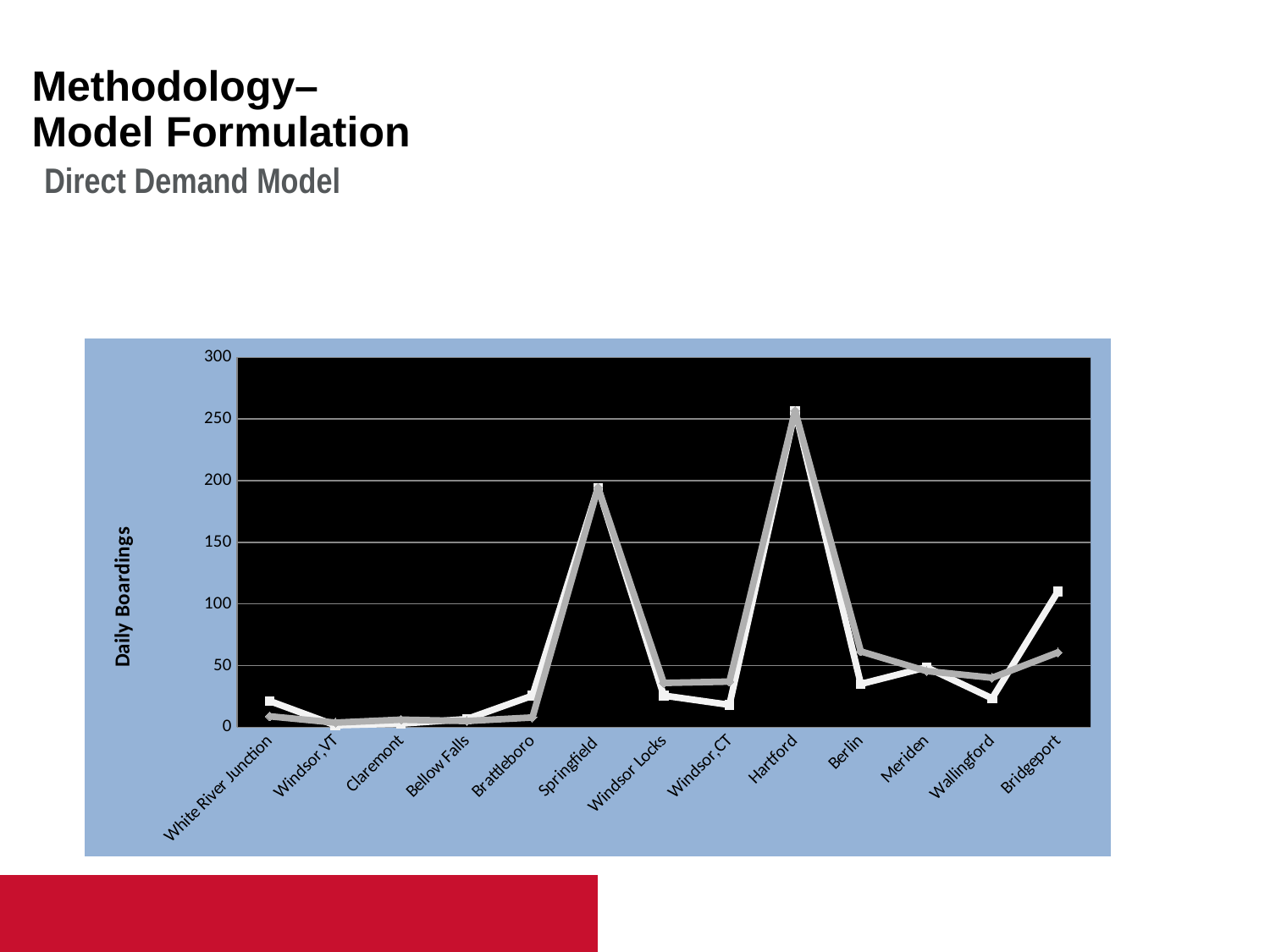
How many stations are listed along the x axis of the chart? 13 Is the value for Wallingford on the white line greater or less than 50? less Which station has the highest daily boardings on the chart? Hartford Is the value for Springfield on the white line greater or less than 150? greater What kind of chart is shown on the slide? line chart What is the highest value shown on the vertical axis of the chart? 300 Which station has the lowest daily boardings on the chart? Windsor, VT Which station has a larger value, Springfield or Hartford? Hartford What is the label on the vertical axis of the chart? Daily Boardings Is the value for Hartford greater or less than 200? greater How many lines are plotted on the chart? 2 Do the values rise or fall from Springfield to Windsor Locks? fall